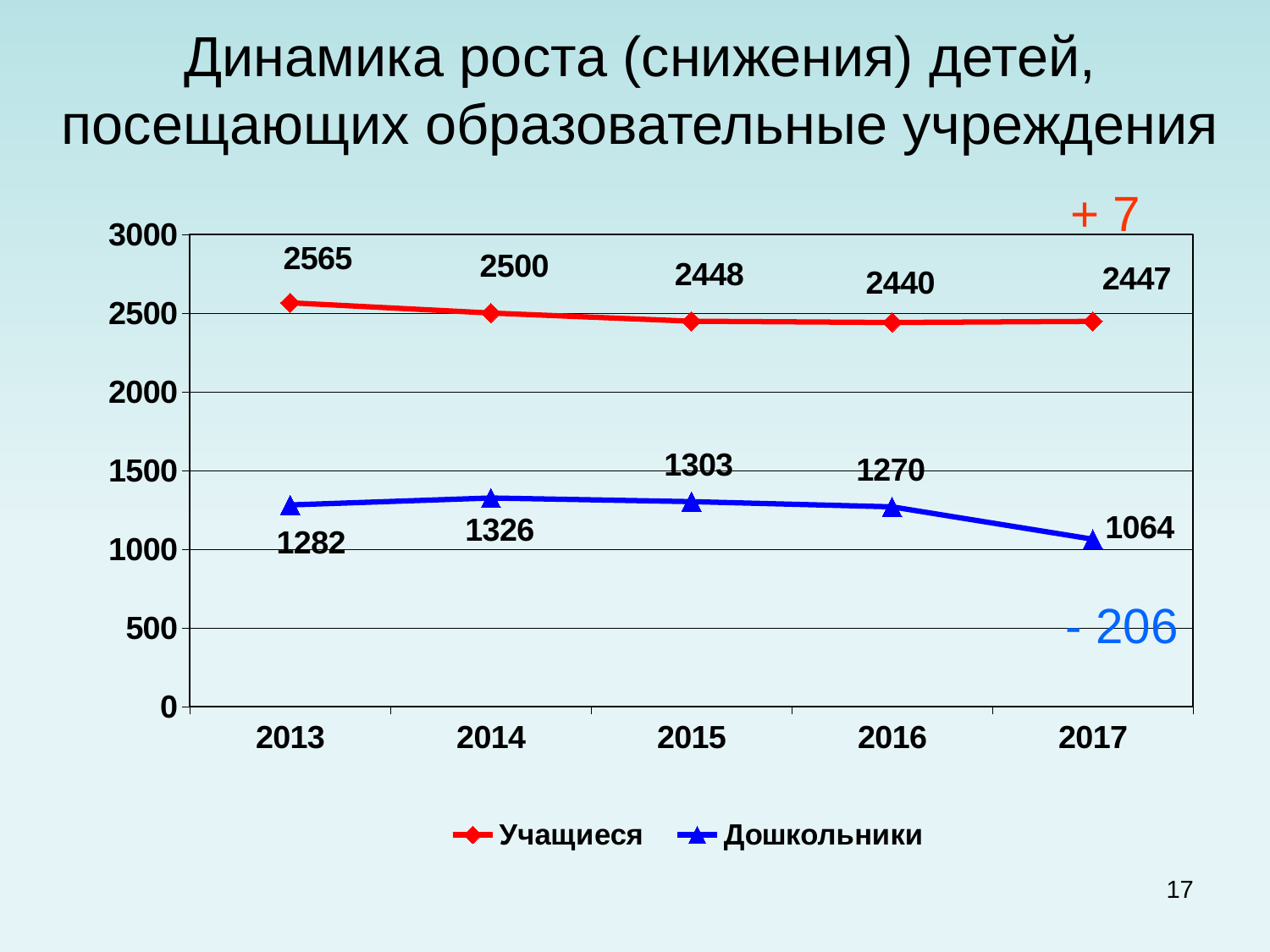
What kind of chart is shown on the slide? line chart In which year is the value for Учащиеся highest? 2013 What is the value for Учащиеся in 2013? 2565 What is the value for Дошкольники in 2017? 1064 Does the value for Дошкольники rise or fall from 2014 to 2017? fall What is the difference between the Учащиеся values in 2013 and 2017? 118 In which year is the value for Дошкольники lowest? 2017 Which is larger in 2015: the value for Учащиеся or the value for Дошкольники? Учащиеся How many series does the legend list? 2 What is the difference between the Дошкольники values in 2016 and 2017? 206 How many years are shown on the x axis? 5 What is the value for Дошкольники in 2014? 1326